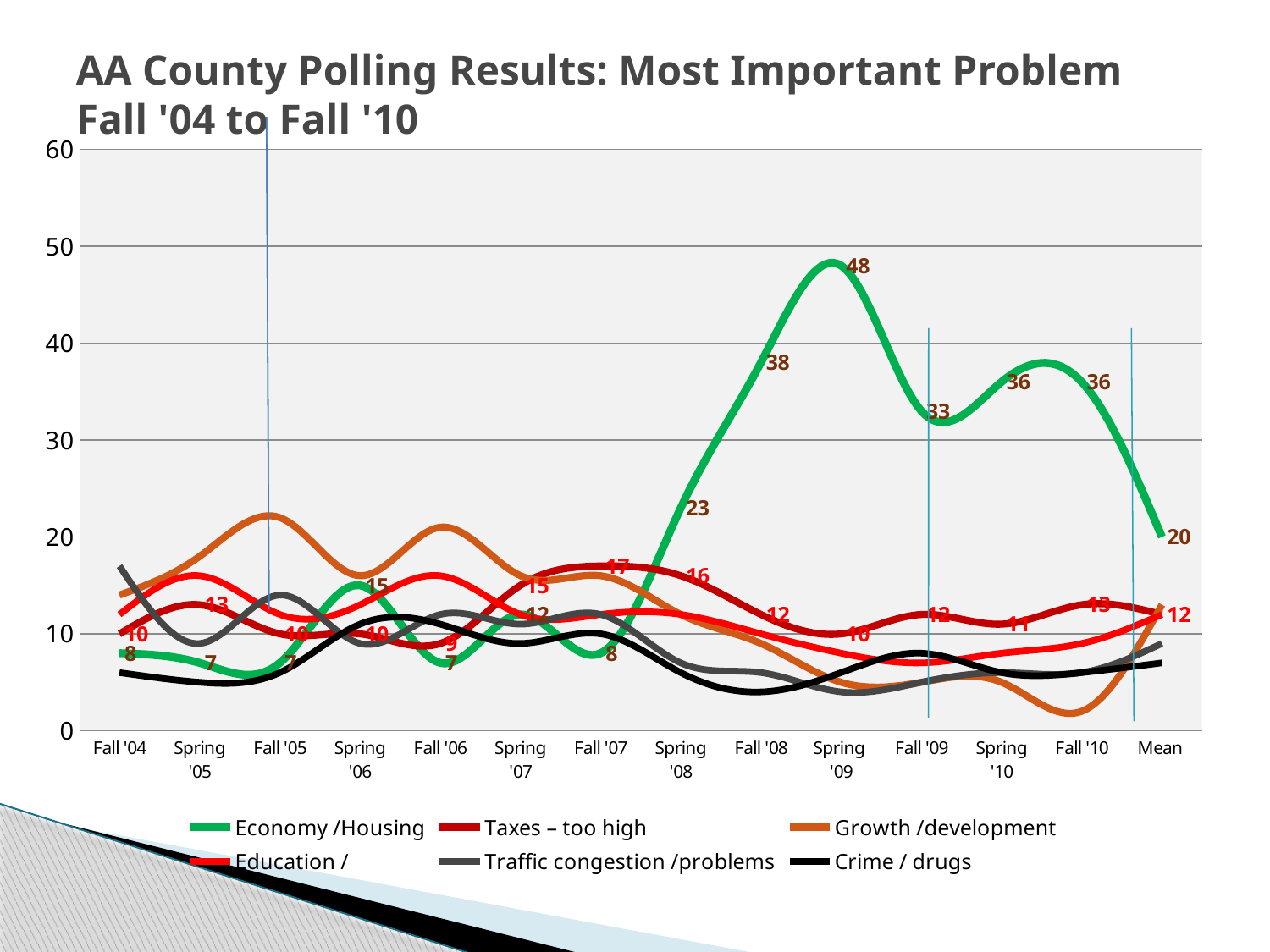
What is the value for Economy /Housing in Spring '09? 48 In which period does Economy /Housing reach its highest value? Spring '09 Is the value for Growth /development in Fall '10 greater or less than 10? less What is the difference between the Economy /Housing values for Spring '09 and Fall '08? 10 How many series does the legend list? 6 Does the Economy /Housing line rise or fall from Spring '08 to Spring '09? rise What kind of chart is shown on the slide? line chart What is the title of the chart? AA County Polling Results: Most Important Problem Fall '04 to Fall '10 Which is larger for Economy /Housing: Fall '09 or Spring '10? Spring '10 What is the value for Taxes – too high in Fall '07? 17 What is the Mean value for Economy /Housing? 20 How many categories are shown along the x axis? 14